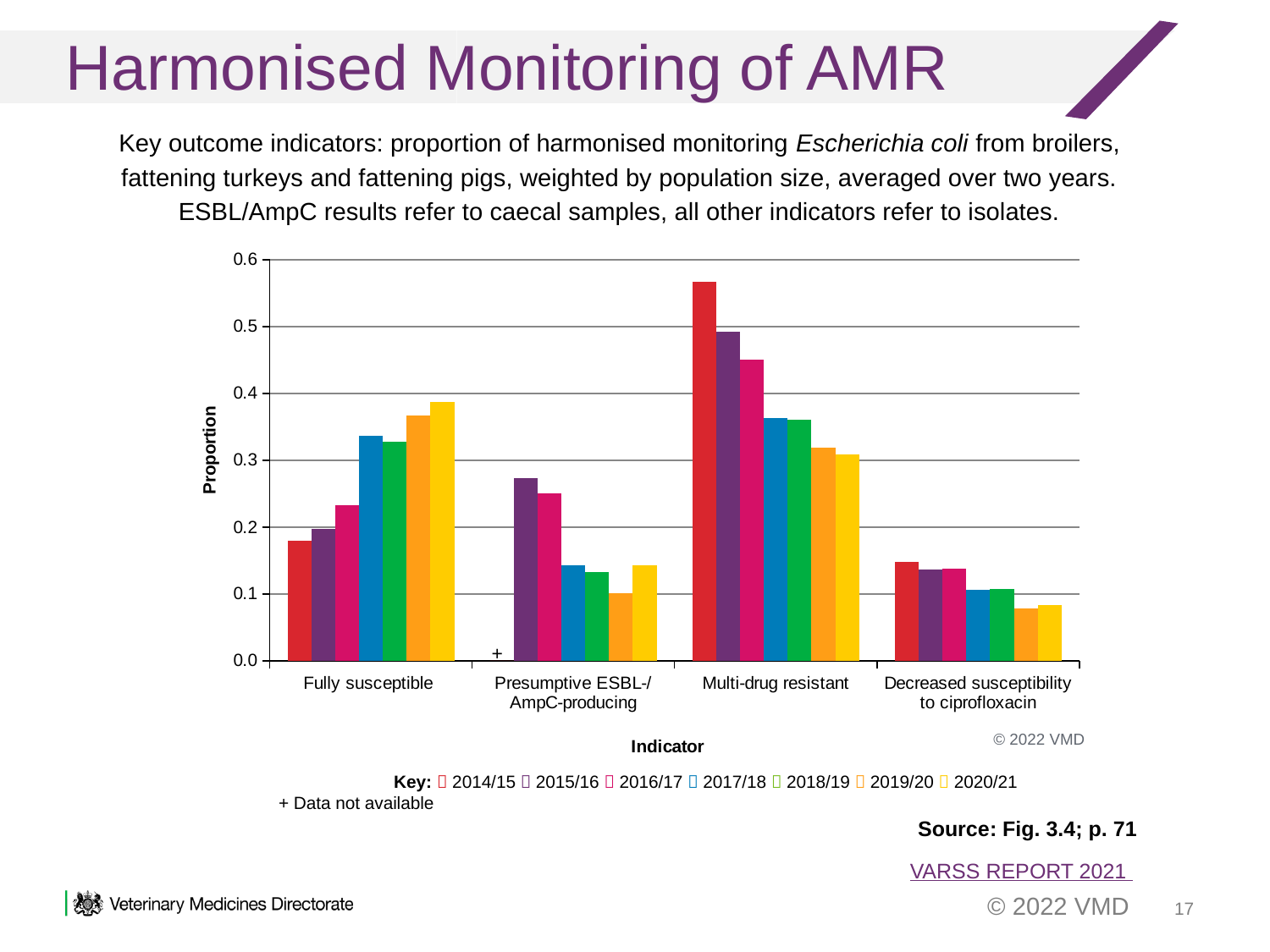
How many series (years) does the key list for the chart? 7 For 2020/21, which is larger: the Fully susceptible value or the Multi-drug resistant value? Fully susceptible Do the Multi-drug resistant values rise or fall from 2014/15 to 2020/21? fall Is the 2019/20 value for Decreased susceptibility to ciprofloxacin greater or less than 0.1? less How many indicator categories are shown on the x axis? 4 Do the Fully susceptible values rise or fall from 2014/15 to 2020/21? rise Which year's data is marked as not available (+) for Presumptive ESBL-/AmpC-producing? 2014/15 Which indicator has the highest bar for 2014/15? Multi-drug resistant Is the 2020/21 value for Fully susceptible greater or less than 0.3? greater Which year has the lowest bar in the Presumptive ESBL-/AmpC-producing group? 2019/20 What kind of chart is shown on the slide? Bar chart Is the 2014/15 value for Multi-drug resistant greater or less than 0.5? greater